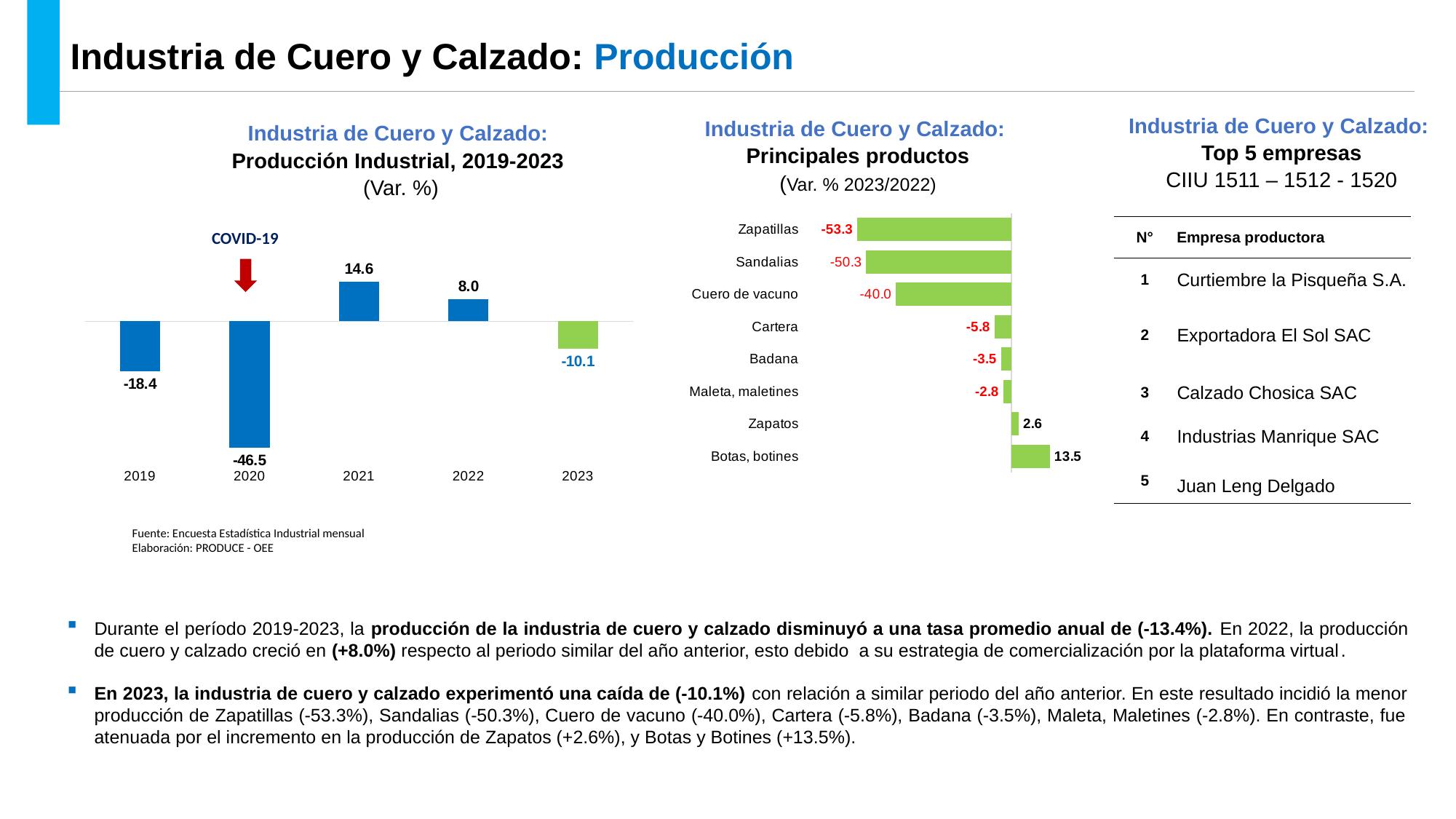
In the 'Producción Industrial, 2019-2023' chart, what is the difference between the values for 2021 and 2022? 6.6 In the 'Producción Industrial, 2019-2023' chart, which year has the lowest value? 2020 In the 'Producción Industrial, 2019-2023' chart, what is the value for 2023? -10.1 In the 'Principales productos' chart, what is the value for Botas, botines? 13.5 In the 'Producción Industrial, 2019-2023' chart, which year has the highest value? 2021 In the 'Producción Industrial, 2019-2023' chart, what is the value for 2020? -46.5 In the 'Producción Industrial, 2019-2023' chart, what label is shown above the 2020 bar with a red arrow? COVID-19 What kind of chart is the 'Principales productos' chart? Bar chart In the 'Principales productos' chart, what is the value for Sandalias? -50.3 In the 'Principales productos' chart, how many products are plotted? 8 In the 'Producción Industrial, 2019-2023' chart, how many years are plotted? 5 In the 'Principales productos' chart, which product has the lowest value? Zapatillas